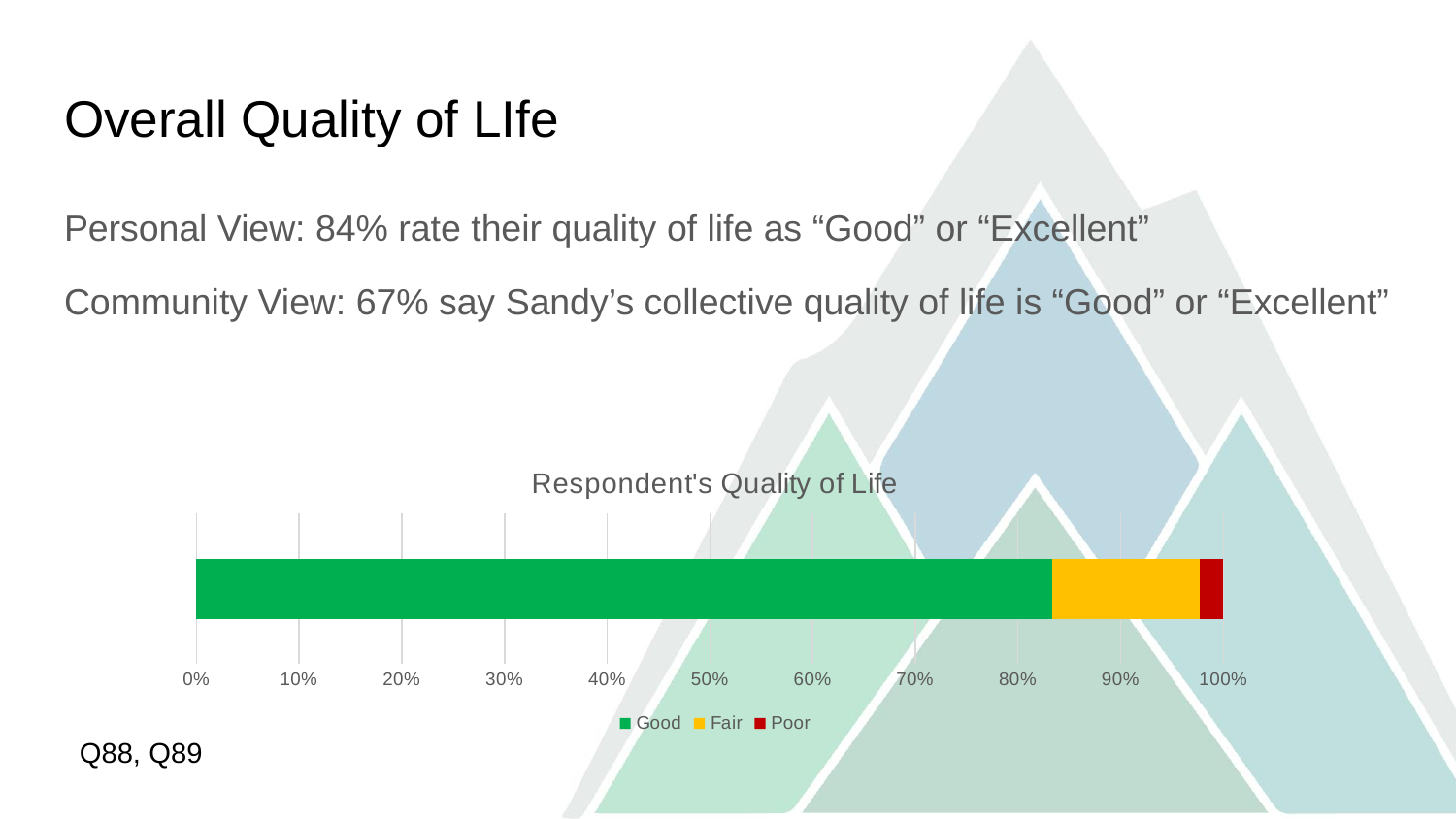
Is the value for Good greater or less than 80%? greater What is the title of the chart? Respondent's Quality of Life Is the value for Good greater or less than 90%? less Which segment of the stacked bar is the largest? Good What kind of chart is shown on the slide? bar chart Is the value for Poor greater or less than 10%? less Which is larger in the chart, the Fair segment or the Poor segment? Fair How many series does the chart's legend list? 3 How many bars are plotted in the chart? 1 Which is larger in the chart, the Good segment or the Fair segment? Good Which series in the chart is shown in green? Good Which segment of the stacked bar is the smallest? Poor